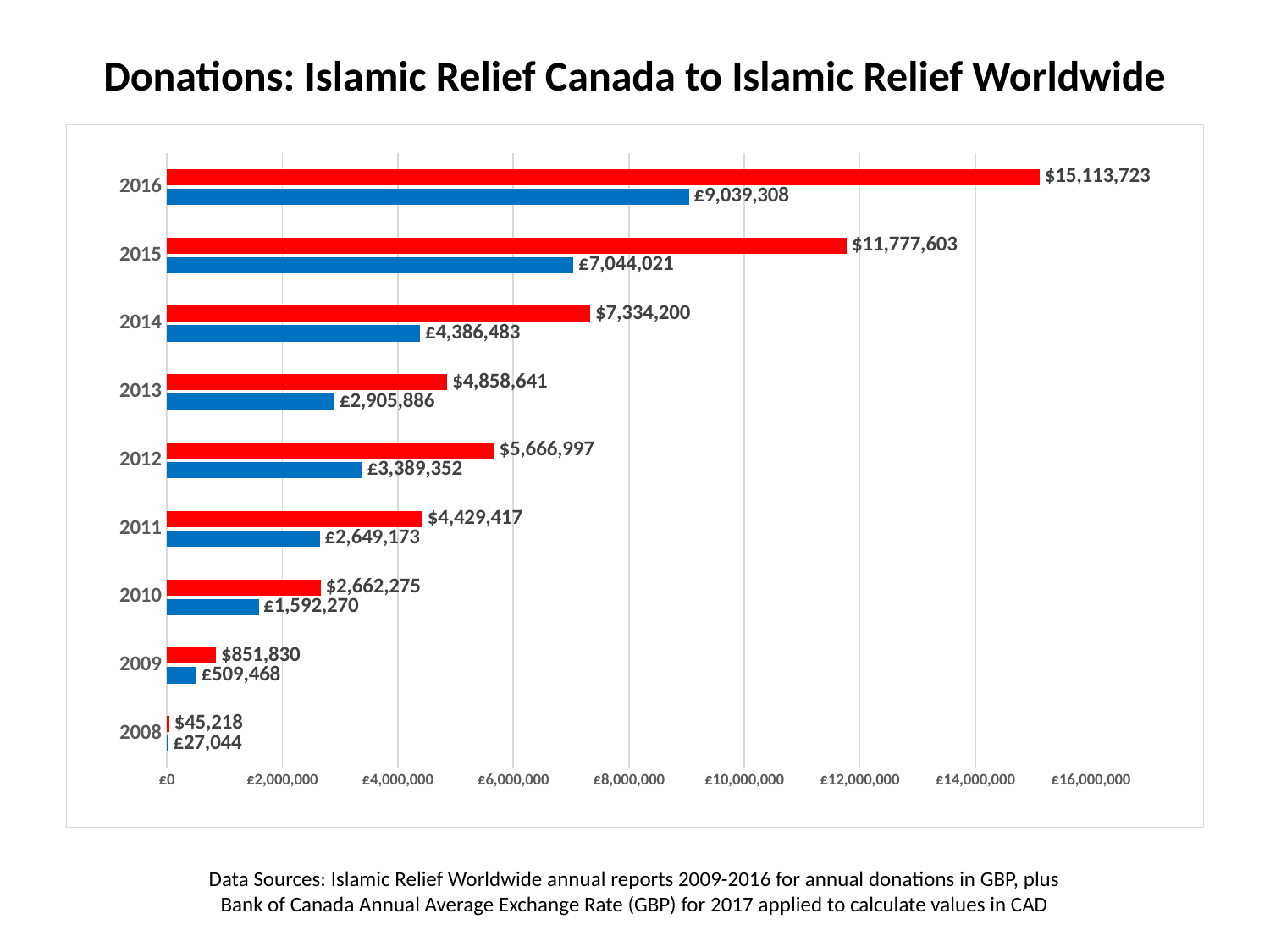
What is the title of the chart? Donations: Islamic Relief Canada to Islamic Relief Worldwide What is the difference between the CAD (red bar) values for 2016 and 2015? $3,336,120 Which year has the lowest GBP (blue bar) donation value? 2008 What kind of chart is shown on the slide? Bar chart What is the CAD (red bar) donation value for 2016? $15,113,723 Which is larger, the CAD (red bar) value for 2012 or for 2013? 2012 What is the GBP (blue bar) donation value for 2009? £509,468 What is the CAD (red bar) donation value for 2012? $5,666,997 Which year has the highest CAD (red bar) donation value? 2016 How many years are shown on the chart? 9 What is the difference between the GBP (blue bar) values for 2016 and 2015? £1,995,287 What is the GBP (blue bar) donation value for 2014? £4,386,483